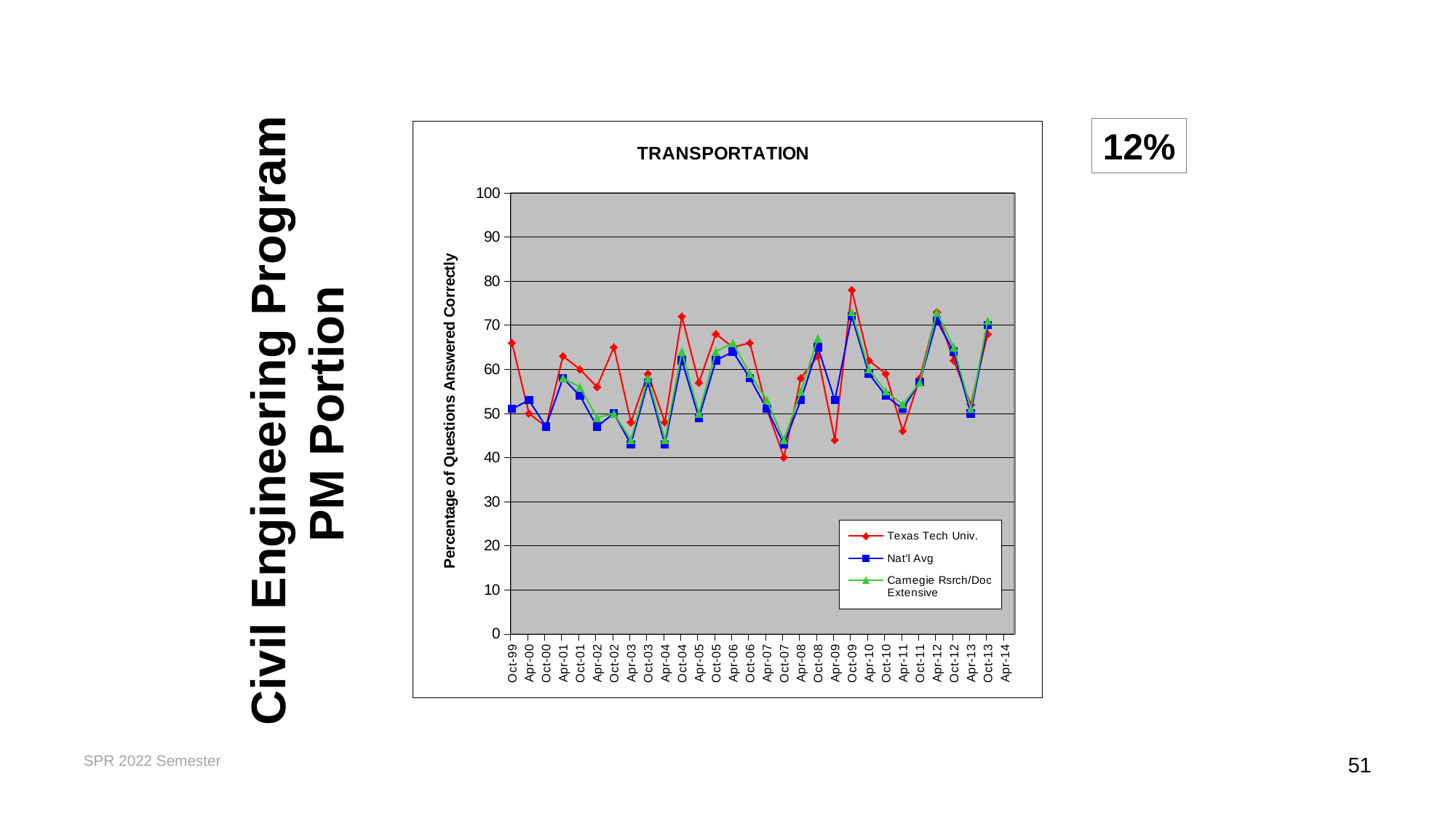
What is the title of the chart? TRANSPORTATION At Oct-04, which is higher: Texas Tech Univ. or Nat'l Avg? Texas Tech Univ. What is the label on the vertical axis of the chart? Percentage of Questions Answered Correctly How many series does the legend of the TRANSPORTATION chart list? 3 What kind of chart is shown on the slide? line chart At which date does the Texas Tech Univ. series reach its highest value? Oct-09 Is the value for Texas Tech Univ. at Oct-09 greater or less than 70? greater Is the value for Texas Tech Univ. at Oct-07 greater or less than 50? less At which date does the Texas Tech Univ. series reach its lowest value? Oct-07 Is the value for Nat'l Avg at Apr-03 greater or less than 50? less At Apr-09, which is higher: Texas Tech Univ. or Nat'l Avg? Nat'l Avg